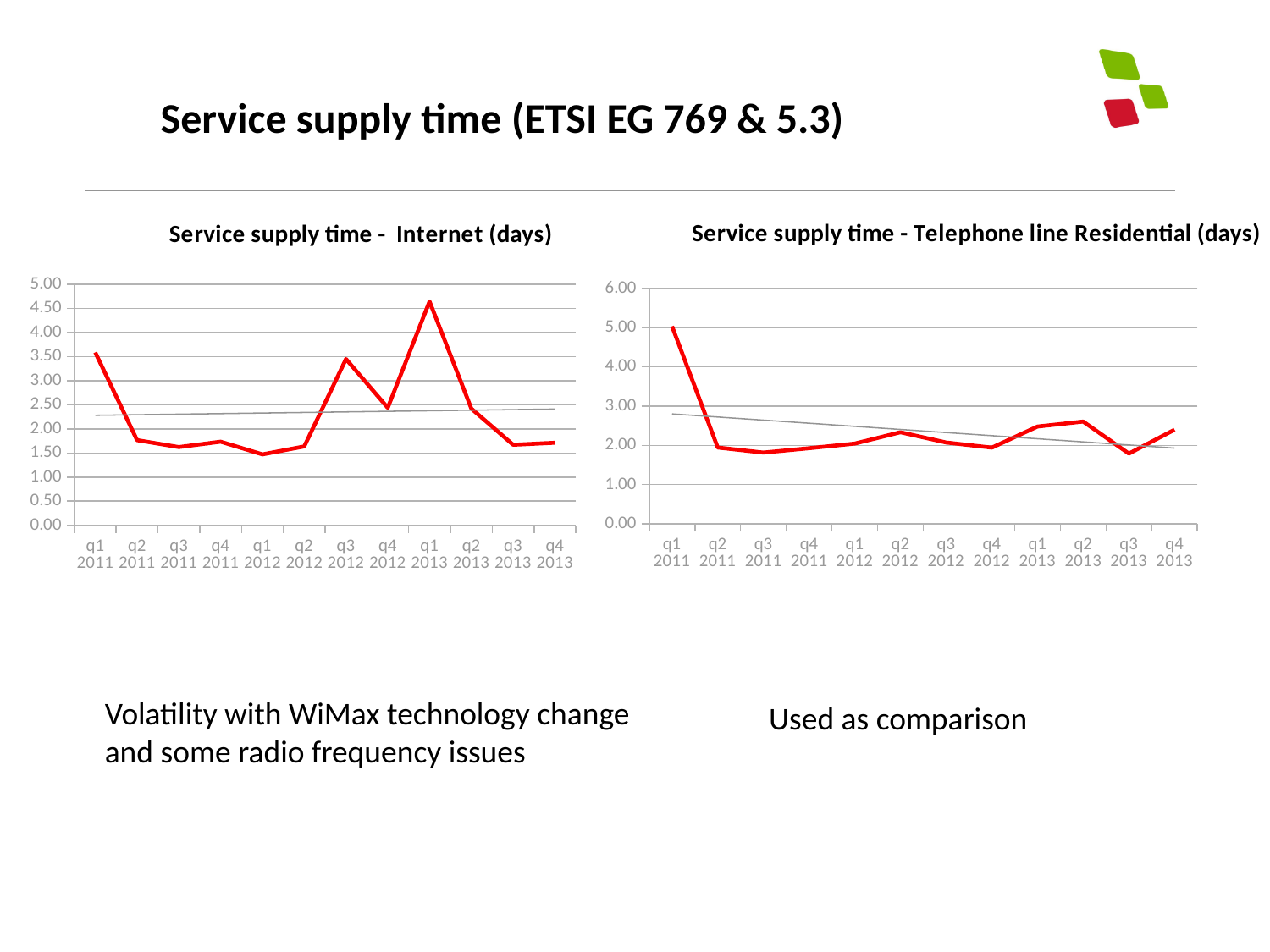
On the 'Service supply time - Internet (days)' chart, is the value for q1 2013 greater or less than 4.00? greater On the 'Service supply time - Internet (days)' chart, is the value for q1 2012 greater or less than 2.00? less On the 'Service supply time - Internet (days)' chart, which is larger, the value for q3 2012 or q4 2012? q3 2012 On the 'Service supply time - Telephone line Residential (days)' chart, which quarter has the highest value? q1 2011 On the 'Service supply time - Internet (days)' chart, which quarter has the lowest value? q1 2012 What kind of chart is the 'Service supply time - Internet (days)' chart? line chart How many quarterly data points are plotted on the 'Service supply time - Internet (days)' chart? 12 What colour is the data line on the 'Service supply time - Internet (days)' chart? red On the 'Service supply time - Telephone line Residential (days)' chart, is the value for q1 2011 greater or less than 4.00? greater On the 'Service supply time - Internet (days)' chart, which quarter has the highest value? q1 2013 On the 'Service supply time - Telephone line Residential (days)' chart, does the grey trend line rise or fall from left to right? fall What is the title of the chart on the right side of the slide? Service supply time - Telephone line Residential (days)